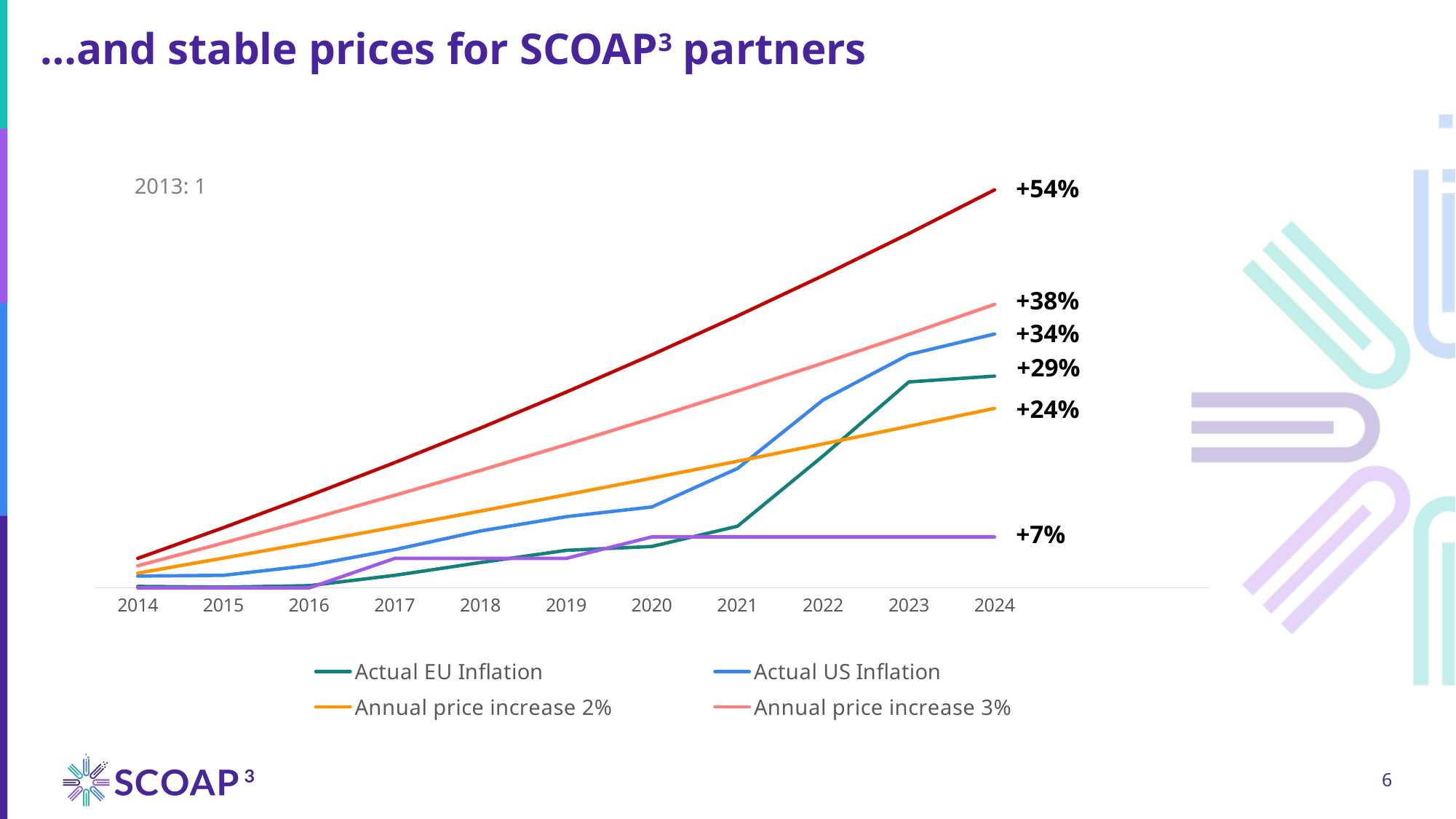
Which is higher in 2024, Actual US Inflation or Actual EU Inflation? Actual US Inflation Does the Annual price increase 2% line rise or fall from 2014 to 2024? rise What is the 2024 end value labelled for Annual price increase 2%? +24% What is the highest end value labelled on the chart? +54% What is the difference between the 2024 end values of Annual price increase 3% and Annual price increase 2%? 14 percentage points What is the lowest end value labelled on the chart? +7% What is the 2024 end value labelled for Actual EU Inflation? +29% How many series does the legend list? 4 What is the 2024 end value labelled for Annual price increase 3%? +38% What is the 2024 end value labelled for Actual US Inflation? +34% How many years are shown along the x axis? 11 What kind of chart is shown on the slide? line chart